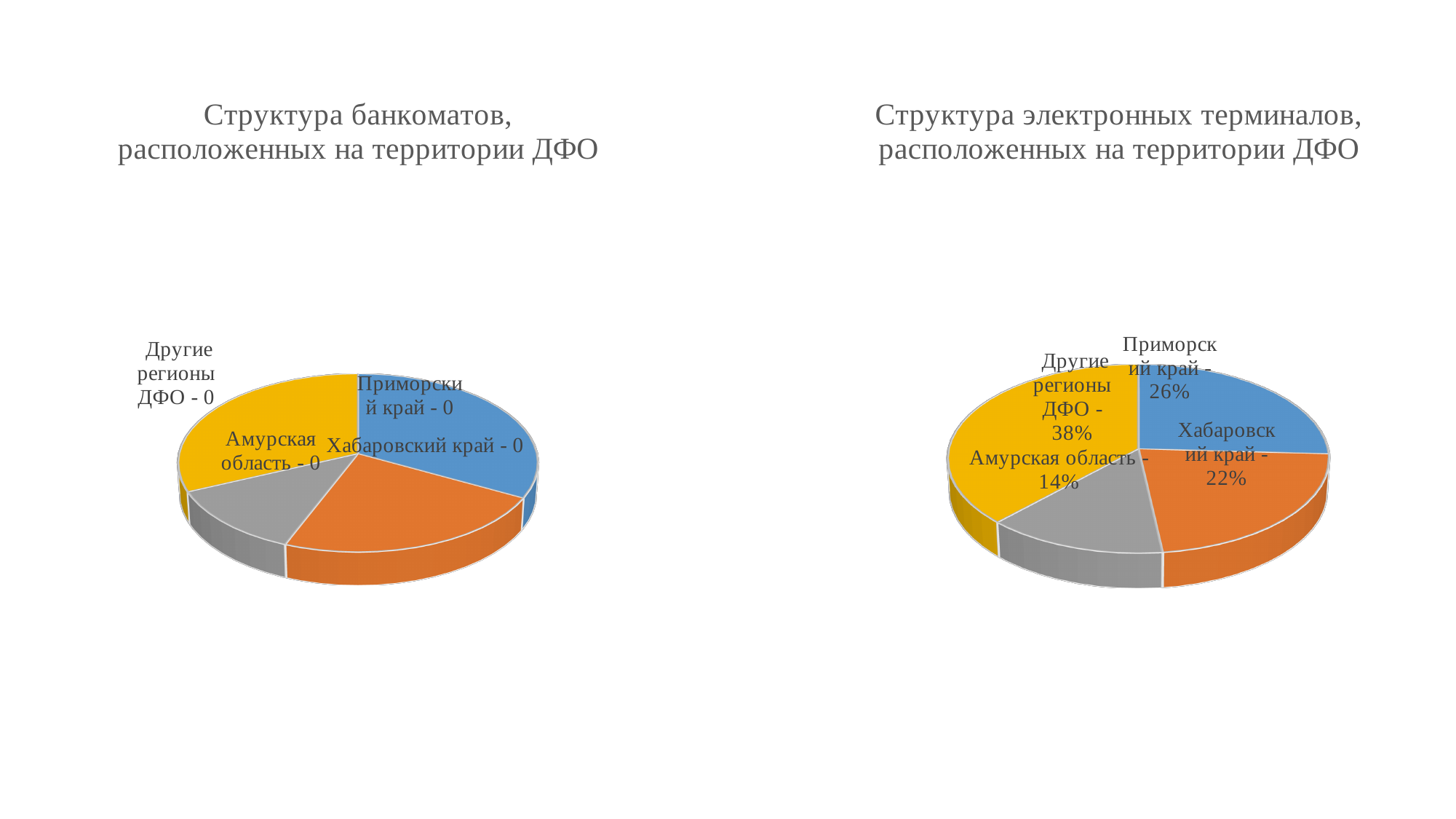
In the chart "Структура электронных терминалов, расположенных на территории ДФО", what share does Хабаровский край have? 22% In the chart "Структура электронных терминалов, расположенных на территории ДФО", which category has the largest share? Другие регионы ДФО How many slices does the chart "Структура электронных терминалов, расположенных на территории ДФО" have? 4 In the chart "Структура электронных терминалов, расположенных на территории ДФО", which category has the smallest share? Амурская область In the chart "Структура банкоматов, расположенных на территории ДФО", which slice is larger: Хабаровский край or Амурская область? Хабаровский край How many slices does the chart "Структура банкоматов, расположенных на территории ДФО" have? 4 In the chart "Структура электронных терминалов, расположенных на территории ДФО", what share does Амурская область have? 14% What type of chart is used in "Структура электронных терминалов, расположенных на территории ДФО"? Pie chart In the chart "Структура электронных терминалов, расположенных на территории ДФО", what is the difference between the shares of Приморский край and Хабаровский край? 4% In the chart "Структура электронных терминалов, расположенных на территории ДФО", what share does Приморский край have? 26% In the chart "Структура электронных терминалов, расположенных на территории ДФО", what share do Другие регионы ДФО have? 38% In the chart "Структура электронных терминалов, расположенных на территории ДФО", which is larger: the share of Хабаровский край or Амурская область? Хабаровский край